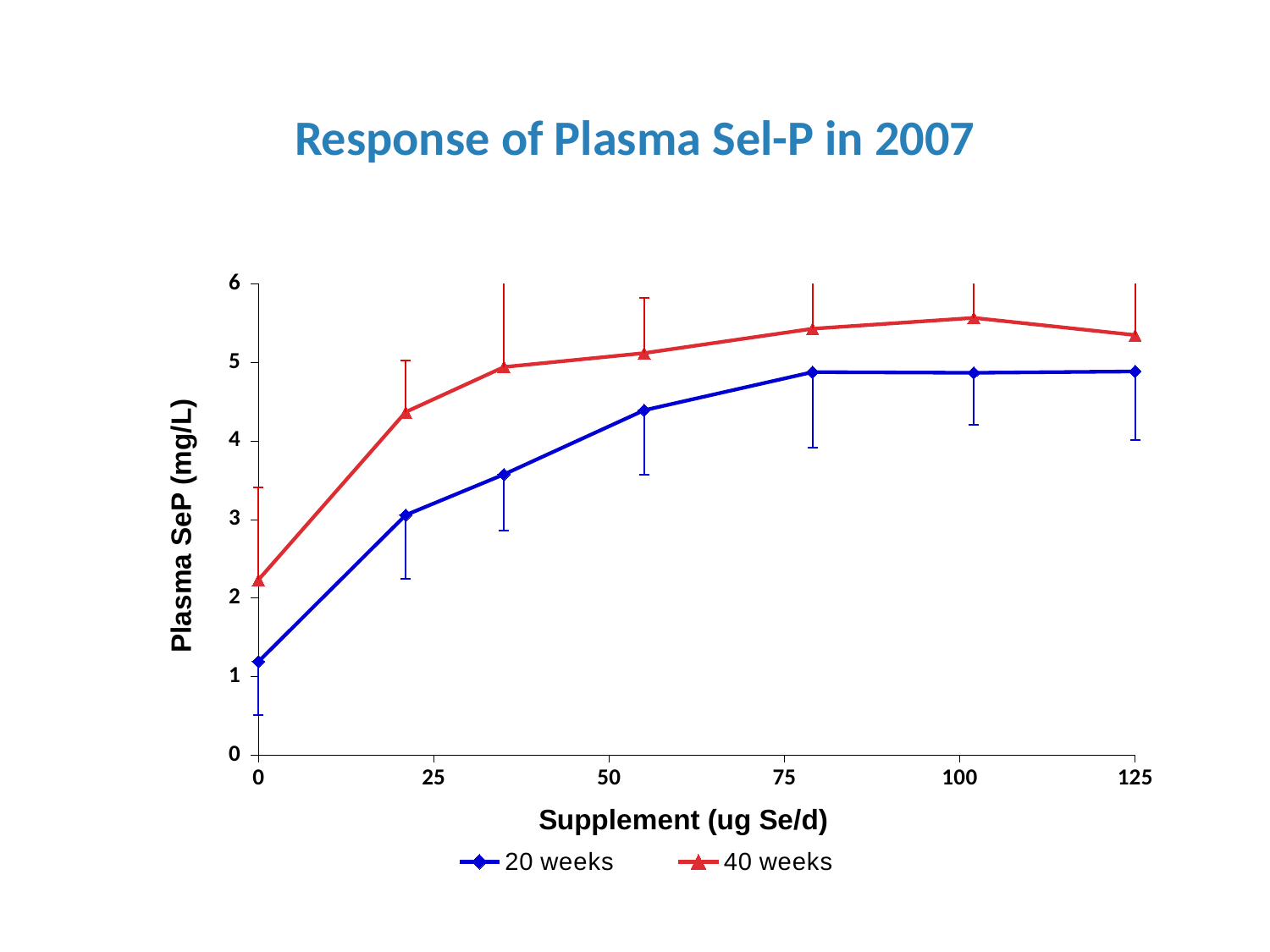
Is the value for the 40 weeks series at supplement 125 greater or less than 5? greater Do the values for the 20 weeks series generally rise or fall as the supplement level increases? rise Is the value for the 40 weeks series at supplement 0 greater or less than 2? greater What kind of chart is shown on the slide? line chart What are the two series named in the legend? 20 weeks and 40 weeks At which supplement level is the 20 weeks series at its lowest? 0 How many series does the legend list? 2 At supplement 0, which series has the higher plasma SeP value, 20 weeks or 40 weeks? 40 weeks How many data points are plotted for the 20 weeks series? 7 Is the value for the 20 weeks series at supplement 0 greater or less than 2? less What is the title of the chart? Response of Plasma Sel-P in 2007